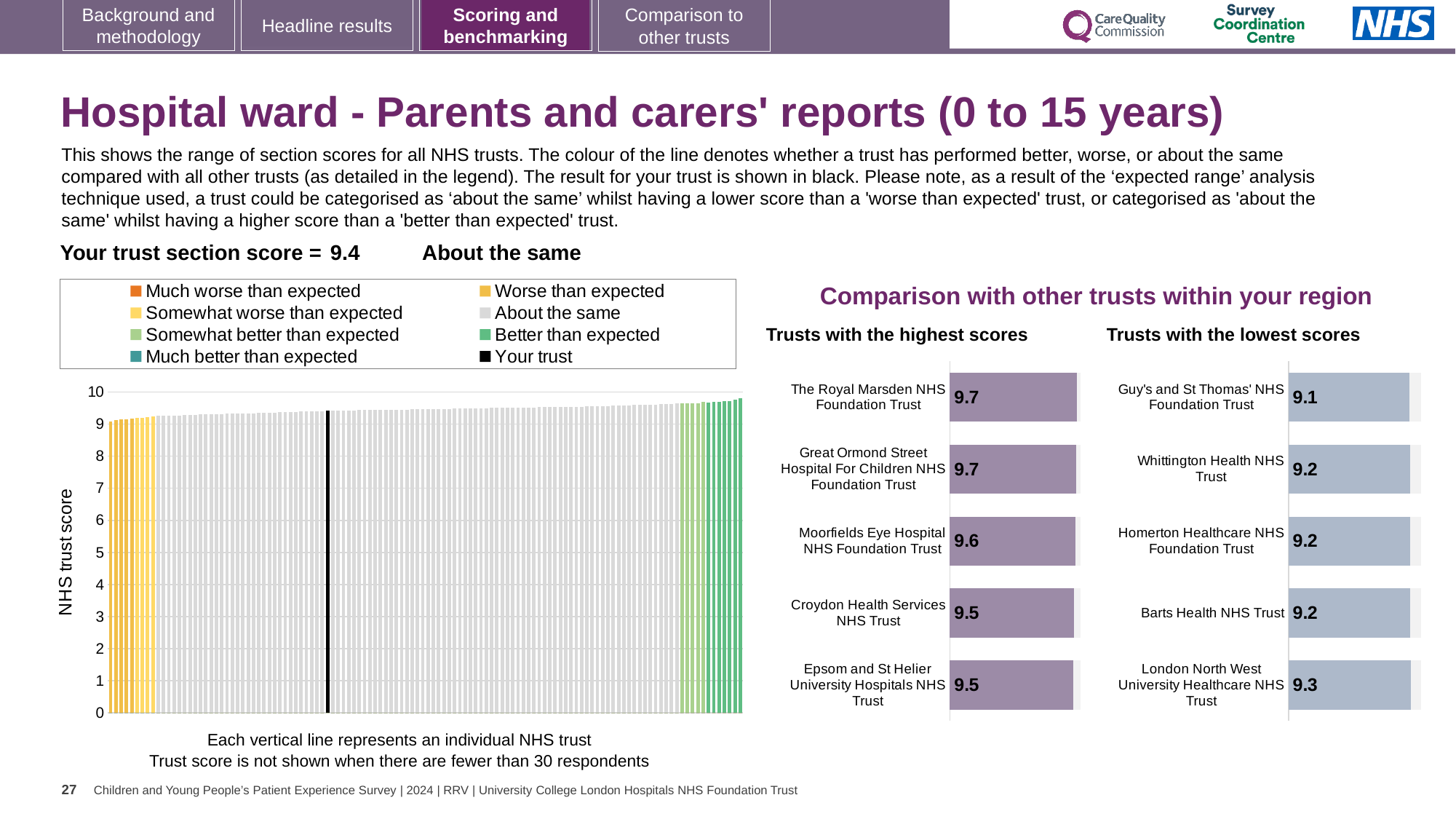
In the 'Trusts with the lowest scores' chart, which trust has the lowest score? Guy's and St Thomas' NHS Foundation Trust In the main 'NHS trust score' chart, is the value for the lowest-scoring trust greater or less than 8? greater In the 'Trusts with the lowest scores' chart, what is the score for Guy's and St Thomas' NHS Foundation Trust? 9.1 In the 'Trusts with the highest scores' chart, what is the difference between the scores of The Royal Marsden NHS Foundation Trust and Croydon Health Services NHS Trust? 0.2 In the 'Trusts with the highest scores' chart, what is the score for Moorfields Eye Hospital NHS Foundation Trust? 9.6 In the 'Trusts with the highest scores' chart, which has the higher score: Moorfields Eye Hospital NHS Foundation Trust or Epsom and St Helier University Hospitals NHS Trust? Moorfields Eye Hospital NHS Foundation Trust In the main 'NHS trust score' chart, what is the section score for your trust (the black line)? 9.4 In the 'Trusts with the lowest scores' chart, which trust has the highest score? London North West University Healthcare NHS Trust How many trusts are shown in the 'Trusts with the highest scores' chart? 5 In the 'Trusts with the lowest scores' chart, what is the difference between the scores of London North West University Healthcare NHS Trust and Guy's and St Thomas' NHS Foundation Trust? 0.2 How many entries does the legend of the main 'NHS trust score' chart list? 8 What kind of chart is the main 'NHS trust score' chart on the left? bar chart